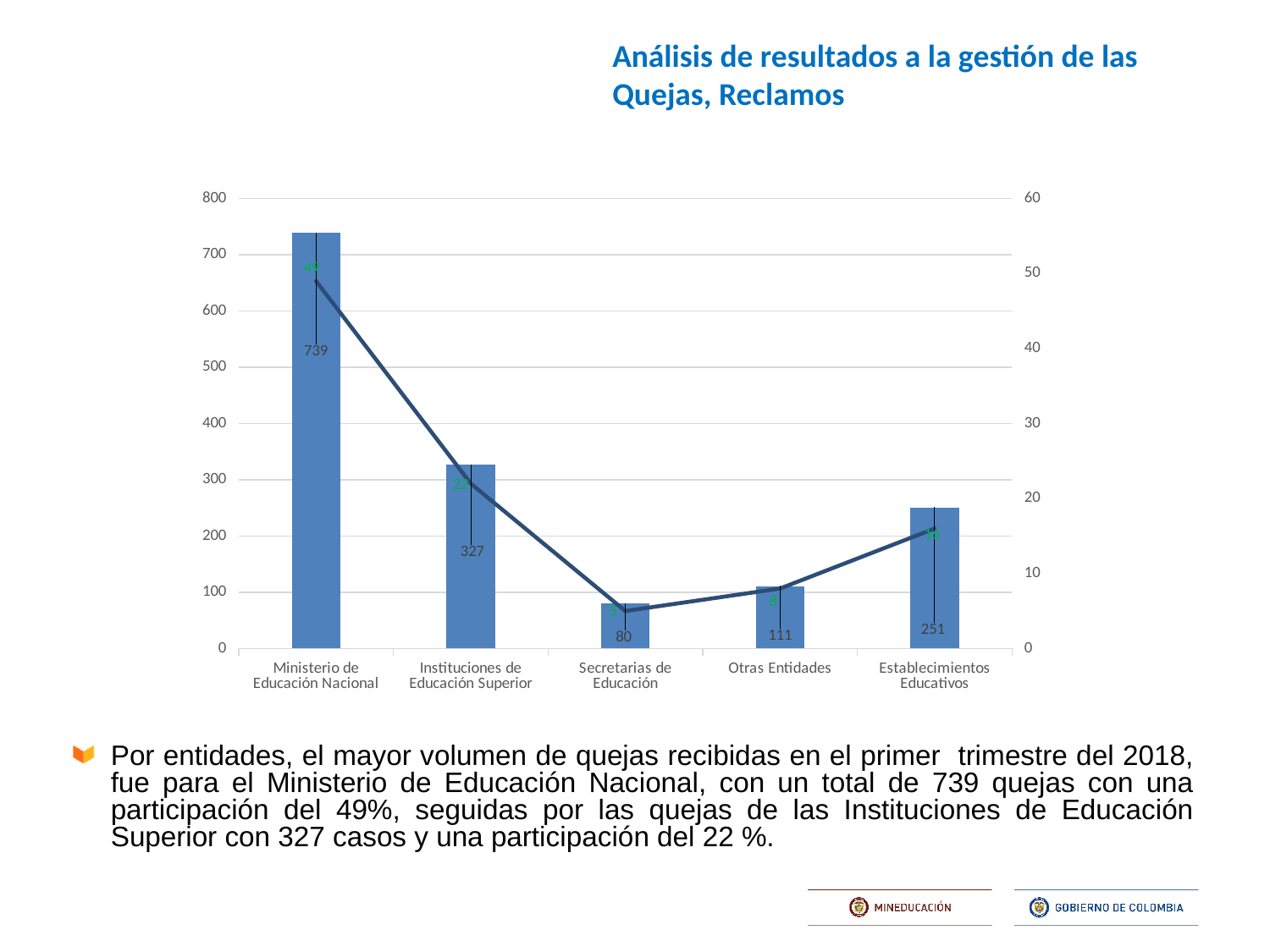
Which category has the lowest bar? Secretarias de Educación Which category has the highest bar? Ministerio de Educación Nacional What is the maximum value shown on the left vertical axis? 800 How many categories are shown on the x axis? 5 What is the value of the bar for Secretarias de Educación? 80 What is the difference between the bars for Ministerio de Educación Nacional and Instituciones de Educación Superior? 412 Which bar is larger, Otras Entidades or Establecimientos Educativos? Establecimientos Educativos What is the value of the bar for Otras Entidades? 111 What kind of chart is shown on the slide? Bar chart with a line overlay How many complaints (quejas) does the bar for Ministerio de Educación Nacional show? 739 What is the value of the bar for Establecimientos Educativos? 251 What is the value of the bar for Instituciones de Educación Superior? 327